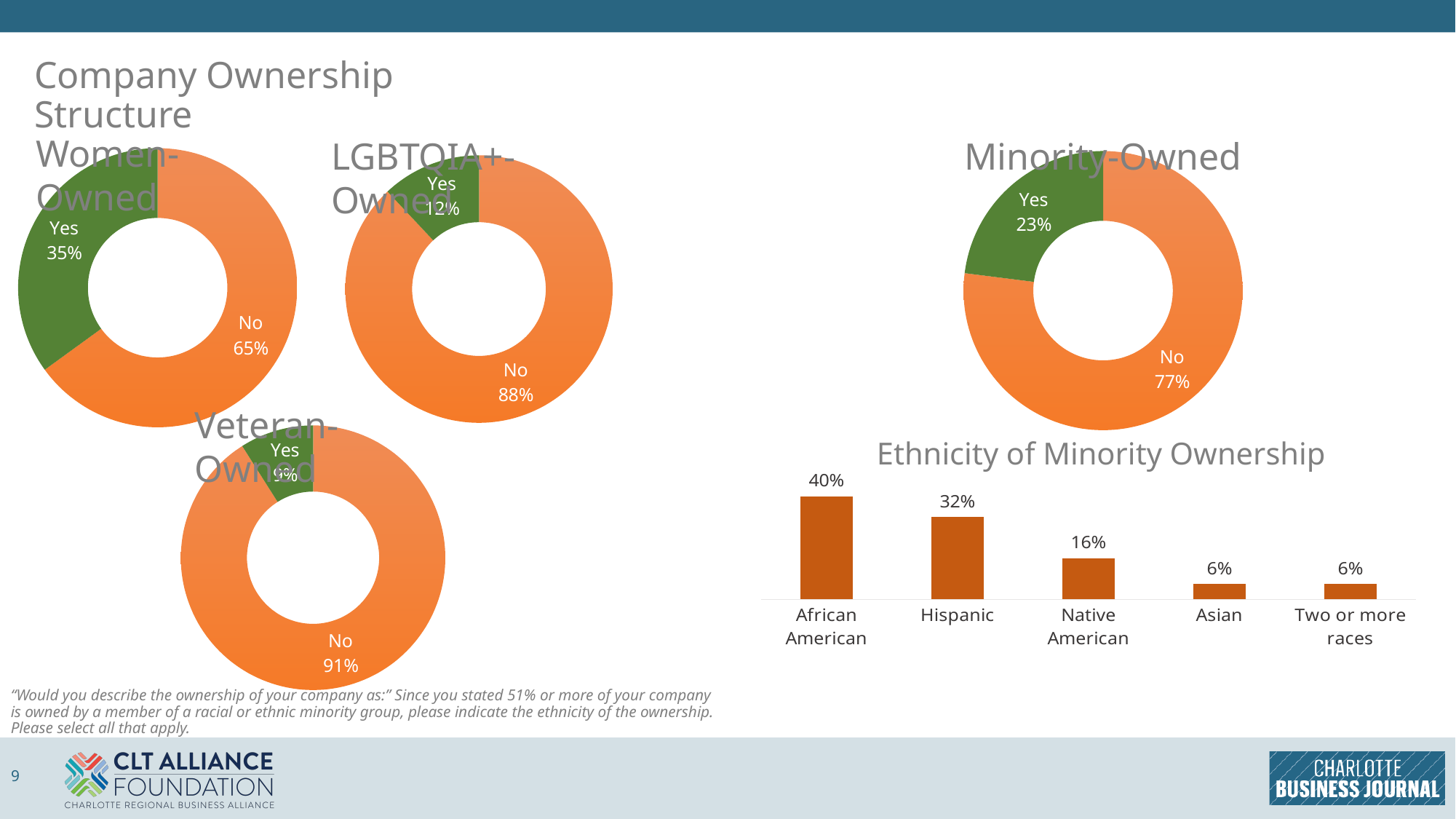
In the LGBTQIA+-Owned chart, what share of the pie is Yes? 12% In the Ethnicity of Minority Ownership chart, which category has the highest value? African American In the LGBTQIA+-Owned chart, what percentage answered No? 88% In the Ethnicity of Minority Ownership chart, what is the difference between African American and Native American? 24% In the Women-Owned chart, what percentage of companies answered No? 65% In the Minority-Owned chart, what percentage answered Yes? 23% What kind of chart is the Ethnicity of Minority Ownership chart? Bar chart In the Women-Owned chart, what percentage of companies answered Yes? 35% In the Veteran-Owned chart, what percentage answered No? 91% In the Minority-Owned chart, what is the difference between the No and Yes percentages? 54% In the Ethnicity of Minority Ownership chart, what is the value for Hispanic? 32% In the Ethnicity of Minority Ownership chart, how many categories are shown? 5